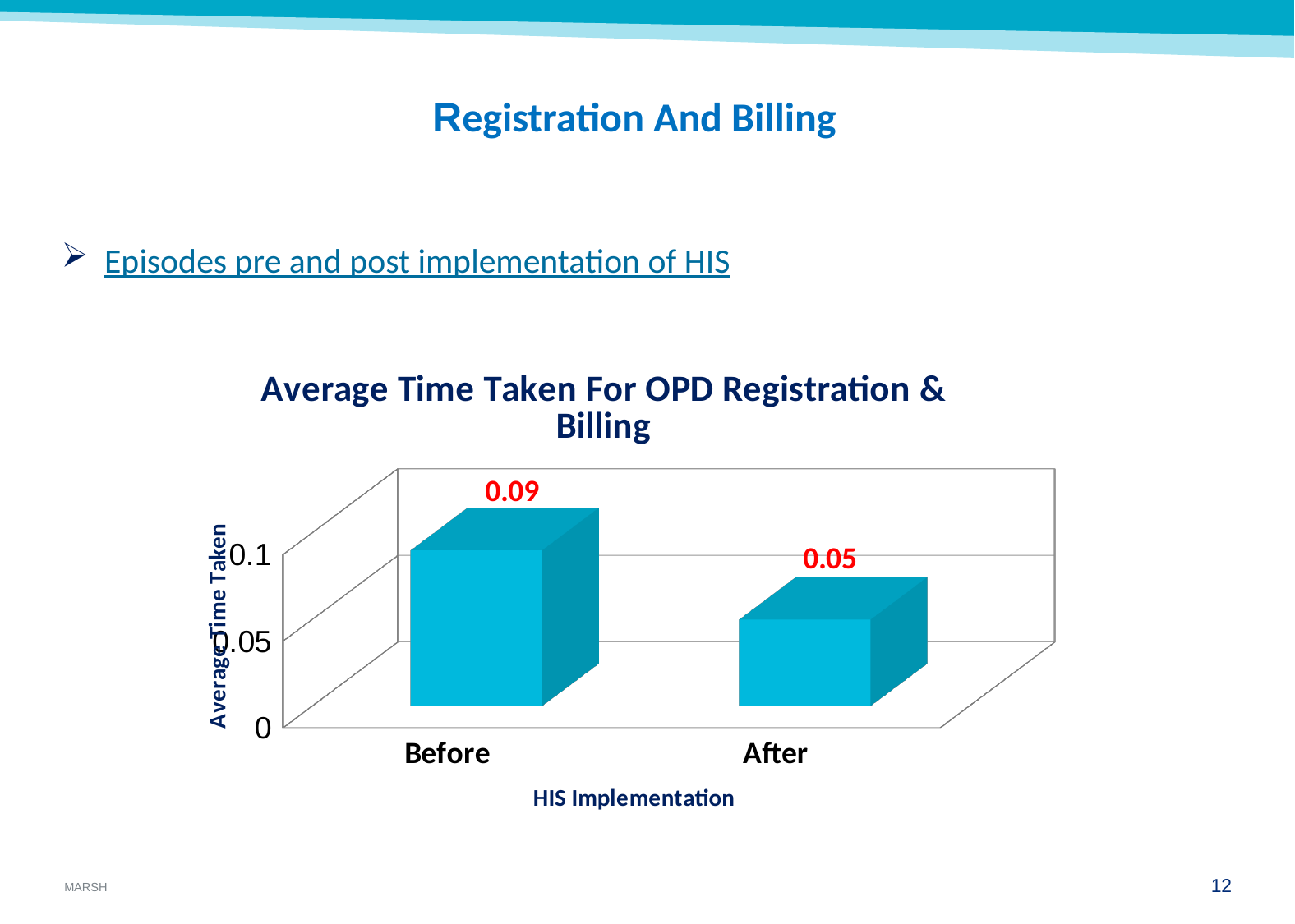
Is the value for Before greater or less than 0.05? greater What is the average time taken for OPD registration & billing after HIS implementation? 0.05 Do the values rise or fall from Before to After along the x axis? fall What is the difference between the average time taken Before and After HIS implementation? 0.04 How many categories are shown on the x axis of the chart? 2 Which category has the higher average time taken, Before or After? Before Is the value for Before larger or smaller than the value for After? larger What kind of chart is shown on the slide? bar chart What is the average time taken for OPD registration & billing before HIS implementation? 0.09 Which category has the lowest average time taken? After What is the title of the chart? Average Time Taken For OPD Registration & Billing What is the label of the x axis of the chart? HIS Implementation